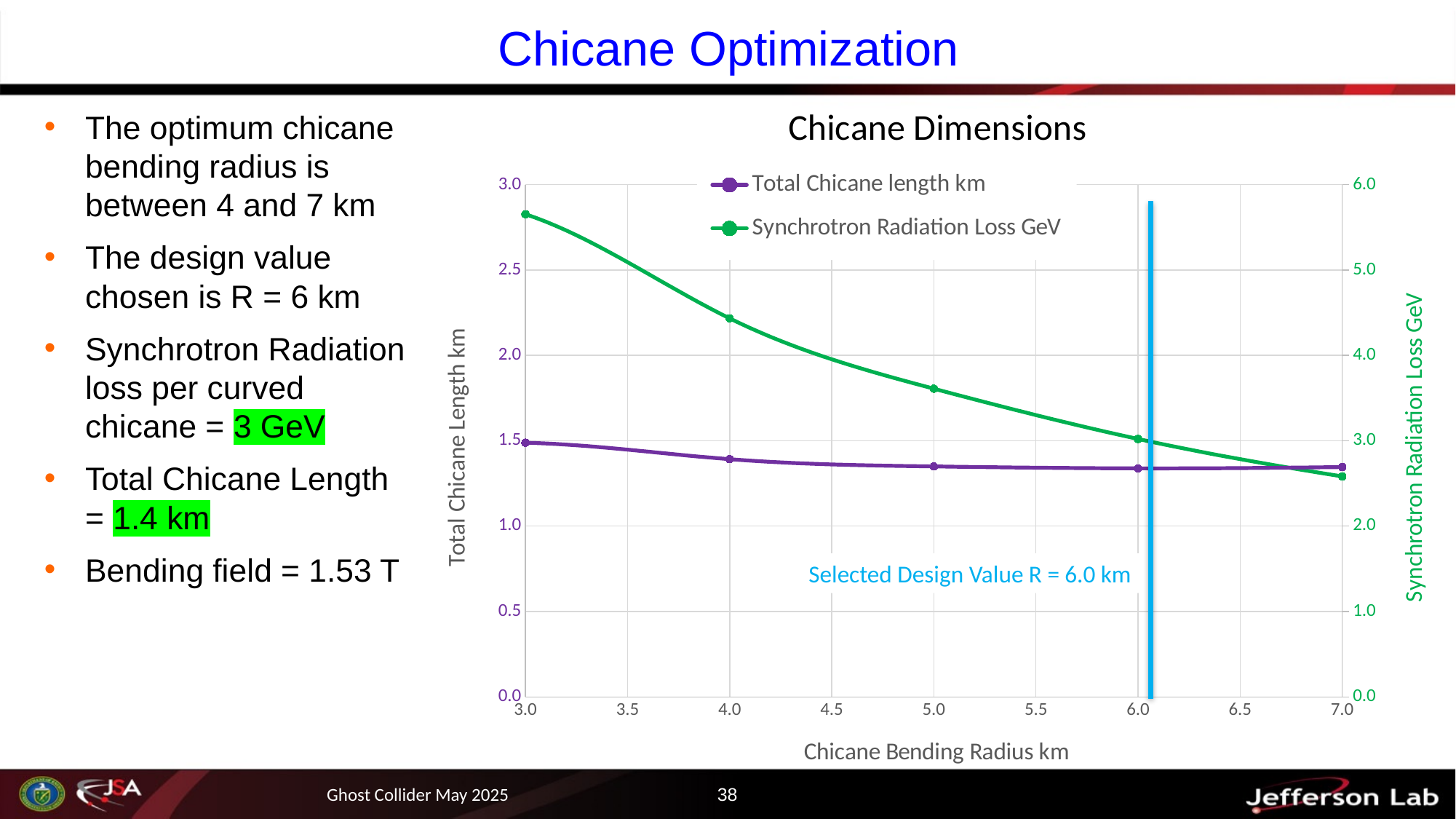
What selected design value does the vertical blue line on the chart mark? R = 6.0 km Does the Synchrotron Radiation Loss GeV series rise or fall as the chicane bending radius increases? fall At which chicane bending radius is the Total Chicane length km highest? 3.0 Is the Synchrotron Radiation Loss GeV at a bending radius of 3.0 km greater or less than 5.0? greater How many data points are plotted for the Synchrotron Radiation Loss GeV series? 5 What is the title of the chart? Chicane Dimensions Is the Synchrotron Radiation Loss GeV at a bending radius of 7.0 km greater or less than 3.0? less What kind of chart is shown on the slide? line chart How many series does the chart legend list? 2 At which chicane bending radius is the Synchrotron Radiation Loss GeV highest? 3.0 Is the Total Chicane length km at a bending radius of 6.0 km greater or less than 1.5? less At which chicane bending radius is the Synchrotron Radiation Loss GeV lowest? 7.0